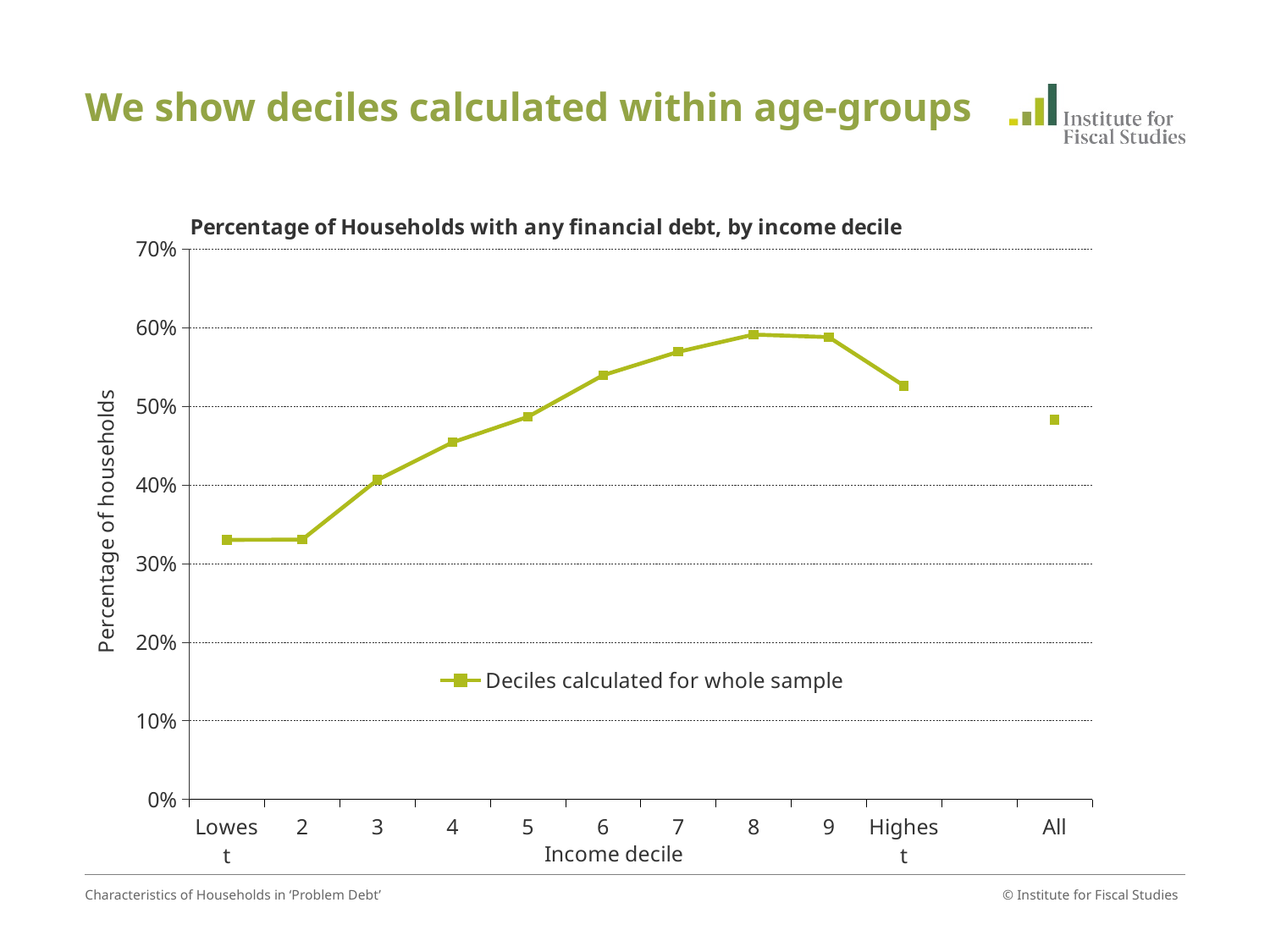
Is the value for income decile 8 greater or less than 50%? greater What is the legend entry for the plotted series? Deciles calculated for whole sample What is the title of the chart? Percentage of Households with any financial debt, by income decile How many categories are shown along the x axis? 11 Is the value for income decile 6 greater or less than 50%? greater Is the value for the Lowest income decile greater or less than 40%? less Which has a higher percentage of households with financial debt: income decile 4 or income decile 6? income decile 6 How many series does the legend list? 1 Which has a higher percentage of households with financial debt: income decile 8 or the Lowest income decile? income decile 8 What kind of chart is shown on the slide? line chart Do the values rise or fall from the Lowest income decile to income decile 8? rise